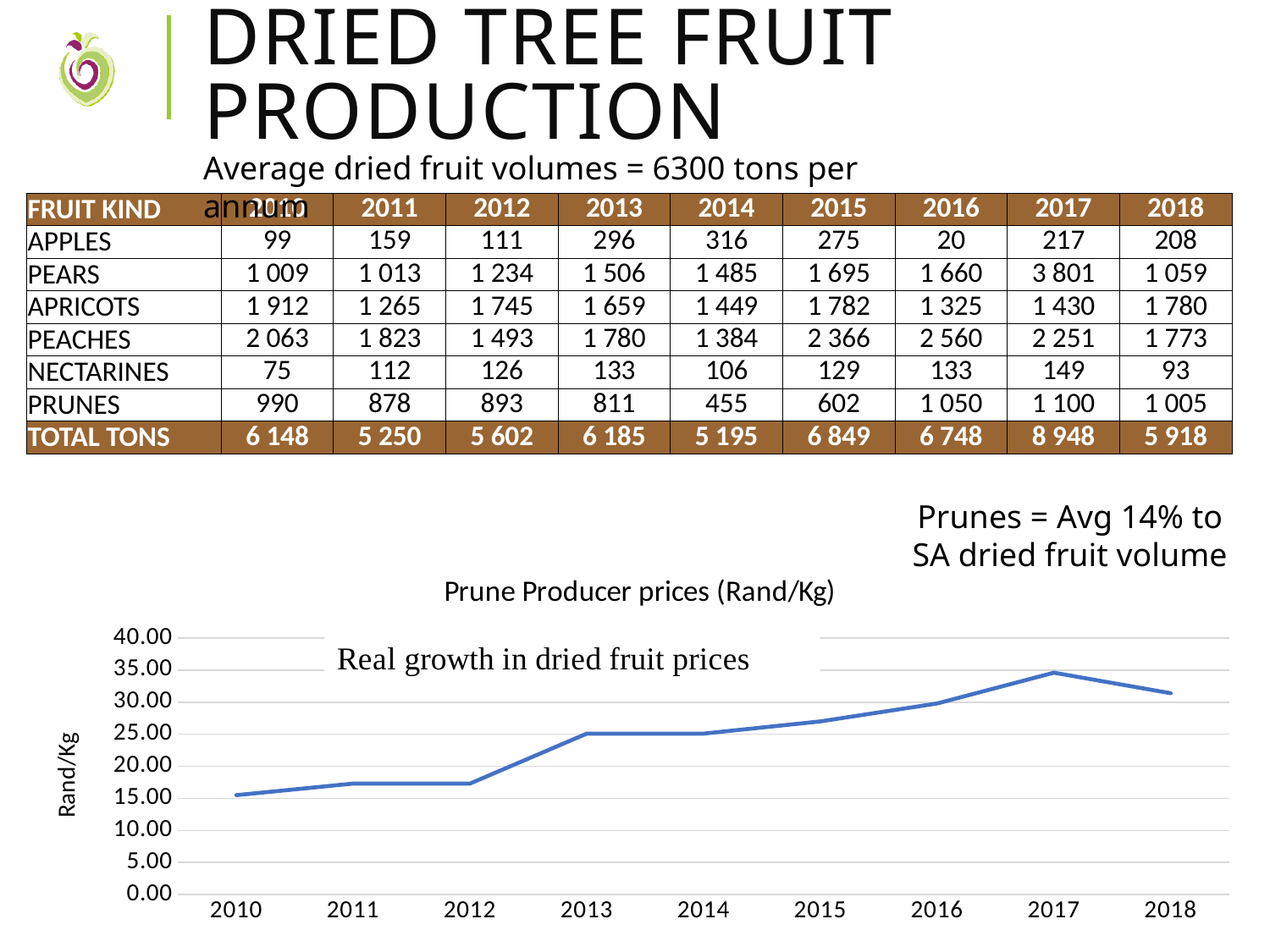
Do prune producer prices generally rise or fall from 2010 to 2017 in the chart? rise In which year is the prune producer price highest in the chart? 2017 Is the prune producer price for 2010 greater or less than 20.00? less What is the label on the vertical axis of the chart? Rand/Kg What kind of chart is shown at the bottom of the slide? Line chart In which year is the prune producer price lowest in the chart? 2010 What is the title of the chart on the slide? Prune Producer prices (Rand/Kg) Is the prune producer price for 2017 greater or less than 30.00? greater How many years are plotted on the x axis of the chart? 9 Is the prune producer price for 2013 greater or less than 20.00? greater Which year has the higher prune producer price, 2012 or 2016? 2016